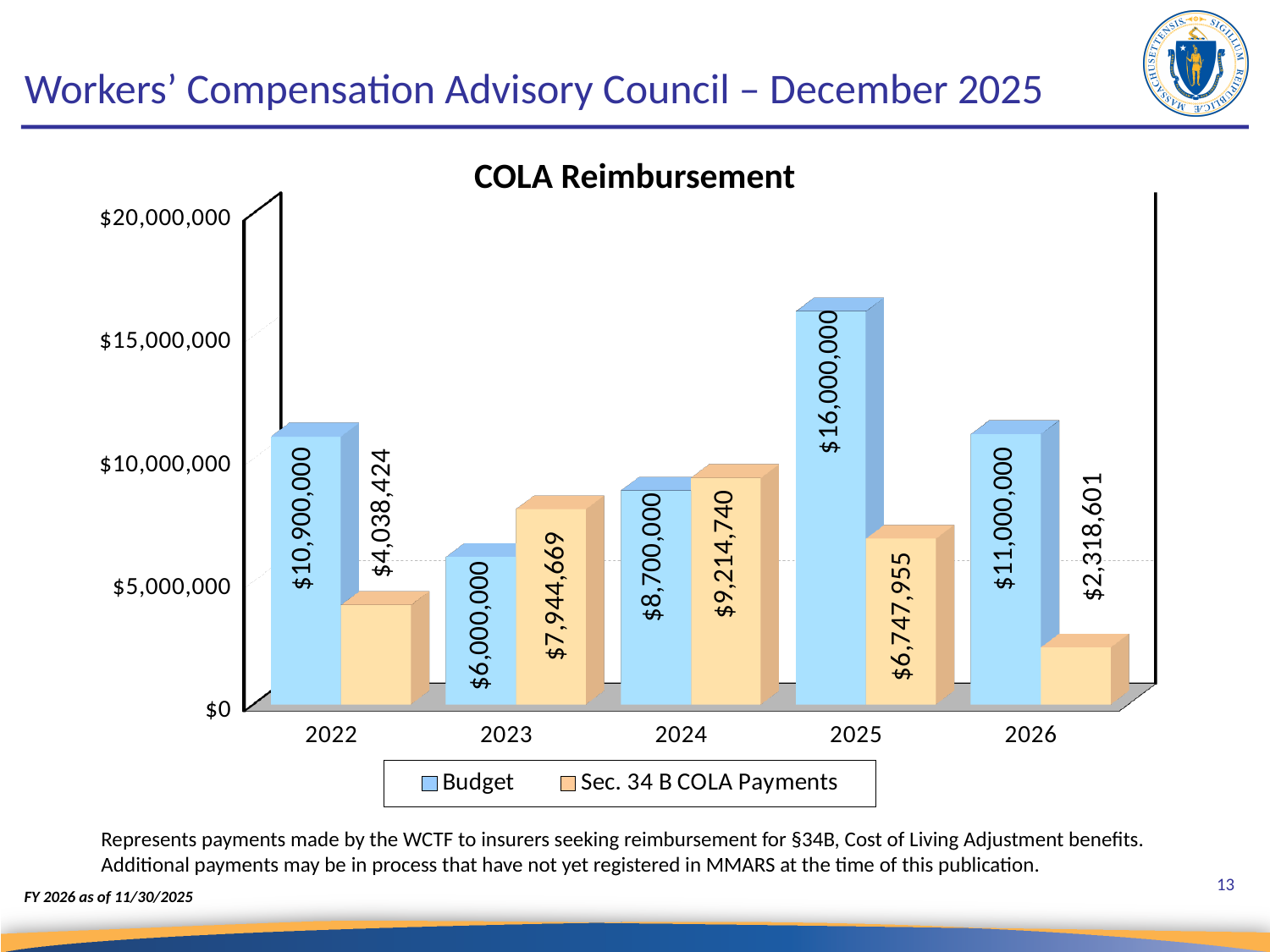
Which year has the highest Budget value? 2025 How many series does the legend list? 2 What type of chart is shown? Bar chart How many years are shown on the x axis? 5 Which year has the highest Sec. 34 B COLA Payments value? 2024 What is the Budget value for 2025? $16,000,000 What is the difference between the Budget and the Sec. 34 B COLA Payments in 2025? $9,252,045 What is the Sec. 34 B COLA Payments value for 2023? $7,944,669 In 2023, which is larger: the Budget or the Sec. 34 B COLA Payments? Sec. 34 B COLA Payments Which year has the lowest Sec. 34 B COLA Payments value? 2026 What is the Budget value for 2022? $10,900,000 What is the Sec. 34 B COLA Payments value for 2026? $2,318,601